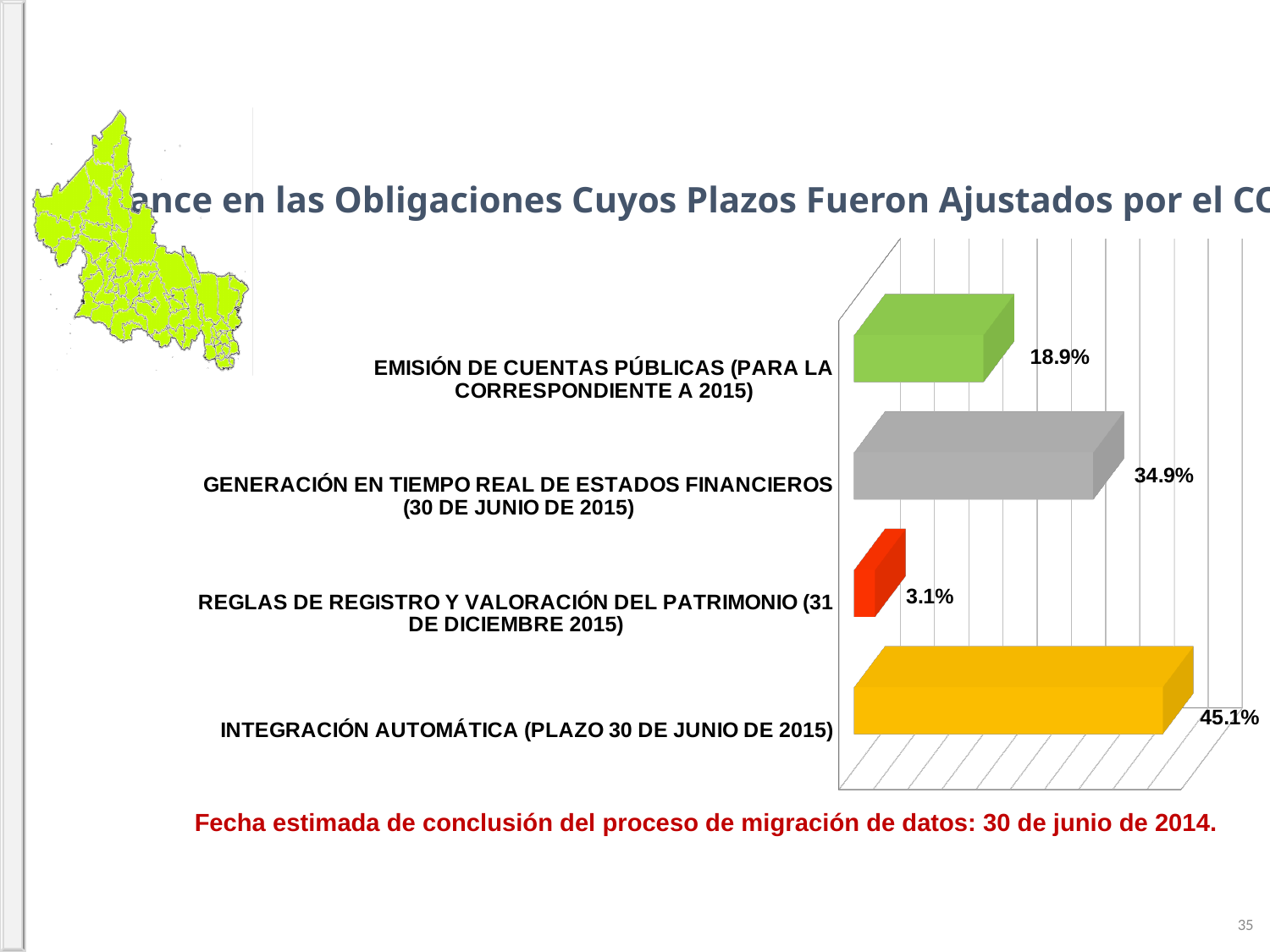
What colour is the bar for INTEGRACIÓN AUTOMÁTICA (PLAZO 30 DE JUNIO DE 2015)? Yellow What is the value for INTEGRACIÓN AUTOMÁTICA (PLAZO 30 DE JUNIO DE 2015)? 45.1% Which is larger, the value for GENERACIÓN EN TIEMPO REAL DE ESTADOS FINANCIEROS or the value for EMISIÓN DE CUENTAS PÚBLICAS? GENERACIÓN EN TIEMPO REAL DE ESTADOS FINANCIEROS What is the difference between the values for INTEGRACIÓN AUTOMÁTICA and GENERACIÓN EN TIEMPO REAL DE ESTADOS FINANCIEROS? 10.2% Which category has the lowest value? REGLAS DE REGISTRO Y VALORACIÓN DEL PATRIMONIO (31 DE DICIEMBRE 2015) How many categories are shown in the chart? 4 What is the value for REGLAS DE REGISTRO Y VALORACIÓN DEL PATRIMONIO (31 DE DICIEMBRE 2015)? 3.1% Which category has the highest value? INTEGRACIÓN AUTOMÁTICA (PLAZO 30 DE JUNIO DE 2015) What is the difference between the values for EMISIÓN DE CUENTAS PÚBLICAS and REGLAS DE REGISTRO Y VALORACIÓN DEL PATRIMONIO? 15.8% What is the value for GENERACIÓN EN TIEMPO REAL DE ESTADOS FINANCIEROS (30 DE JUNIO DE 2015)? 34.9% What kind of chart is shown on the slide? Bar chart What is the value for EMISIÓN DE CUENTAS PÚBLICAS (PARA LA CORRESPONDIENTE A 2015)? 18.9%